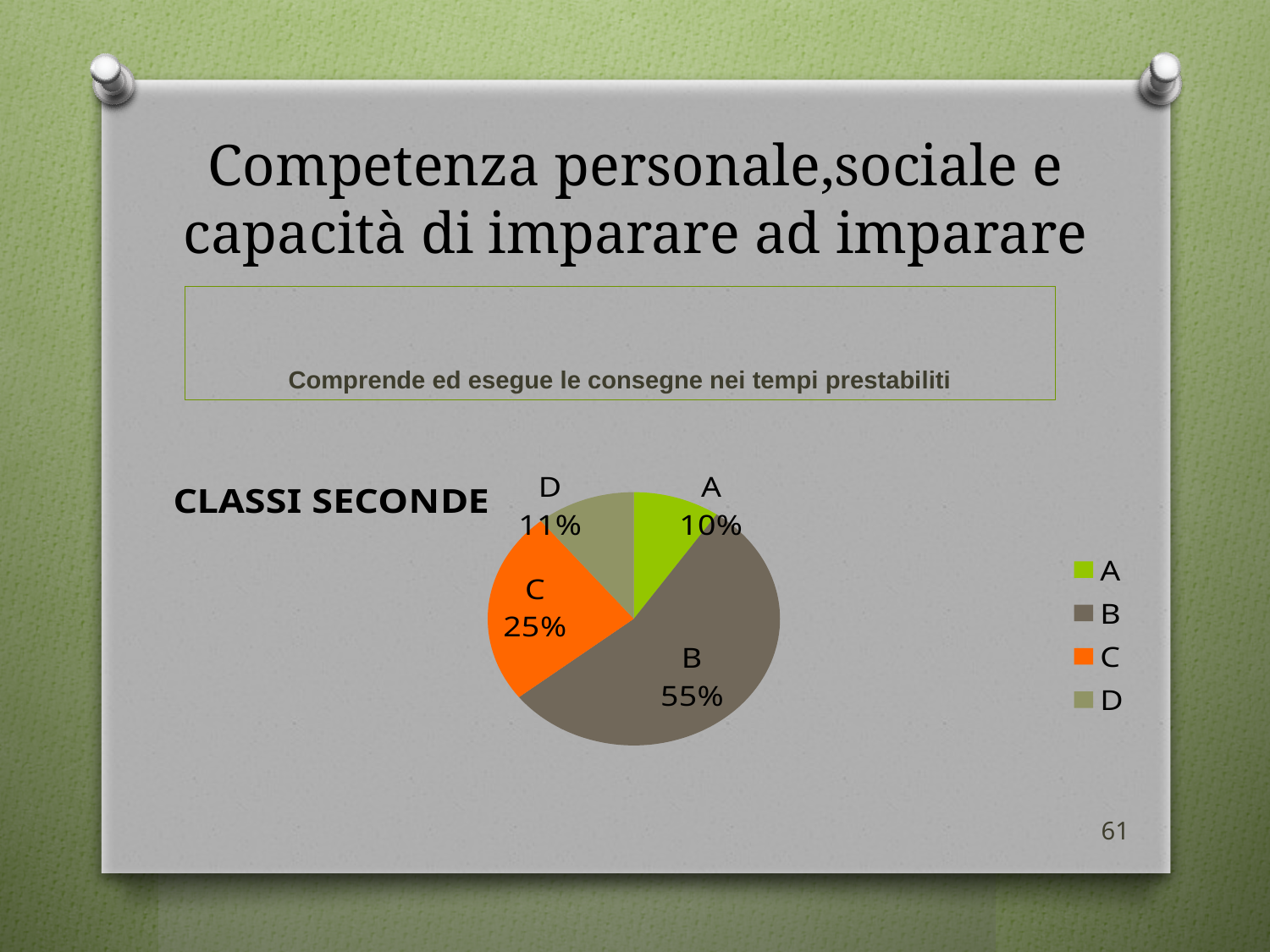
Which category has the smallest share of the pie chart? A What label appears to the left of the pie chart? CLASSI SECONDE What percentage does slice A represent in the pie chart? 10% What percentage does slice D represent in the pie chart? 11% How many entries does the legend list? 4 Which is larger, the share for C or the share for D? C How many slices does the pie chart have? 4 What kind of chart is shown on the slide? pie chart What percentage does slice C represent in the pie chart? 25% Which category has the largest share of the pie chart? B What percentage does slice B represent in the pie chart? 55% What is the difference in percentage points between slice B and slice C? 30